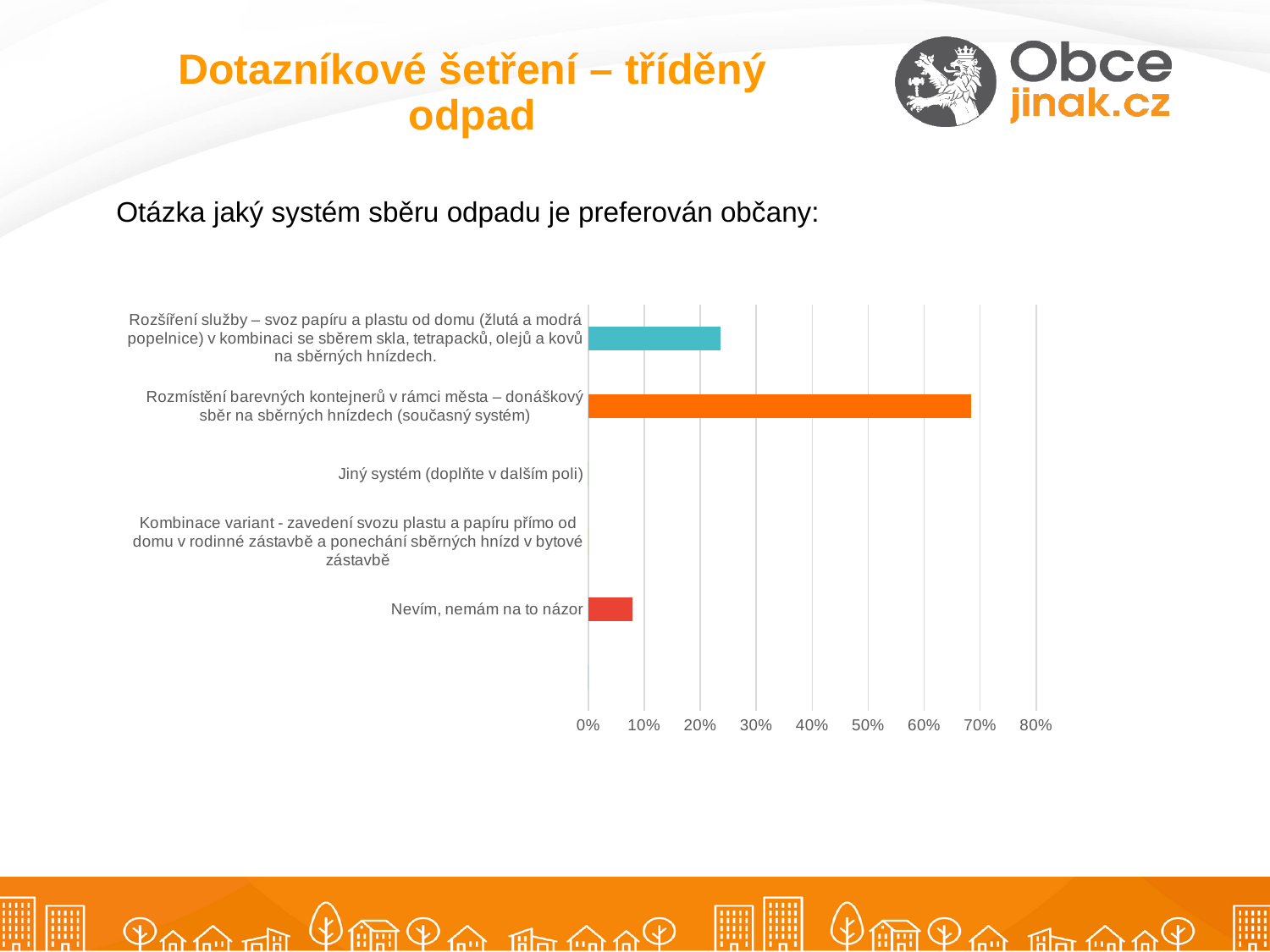
Which has a larger value: "Rozmístění barevných kontejnerů v rámci města..." or "Rozšíření služby – svoz papíru a plastu od domu..."? Rozmístění barevných kontejnerů v rámci města... Is the value for "Nevím, nemám na to názor" greater or less than 10%? less Which has a larger value: "Rozšíření služby – svoz papíru a plastu od domu..." or "Nevím, nemám na to názor"? Rozšíření služby – svoz papíru a plastu od domu... What colour is the longest bar in the chart? orange How many categories are listed on the vertical axis of the chart? 5 What is the highest tick value shown on the horizontal axis of the chart? 80% Which category has the highest value in the chart? Rozmístění barevných kontejnerů v rámci města – donáškový sběr na sběrných hnízdech (současný systém) Is the value for "Rozmístění barevných kontejnerů v rámci města – donáškový sběr na sběrných hnízdech (současný systém)" greater or less than 60%? greater Is the value for "Rozšíření služby – svoz papíru a plastu od domu..." greater or less than 20%? greater What kind of chart is shown on the slide? bar chart